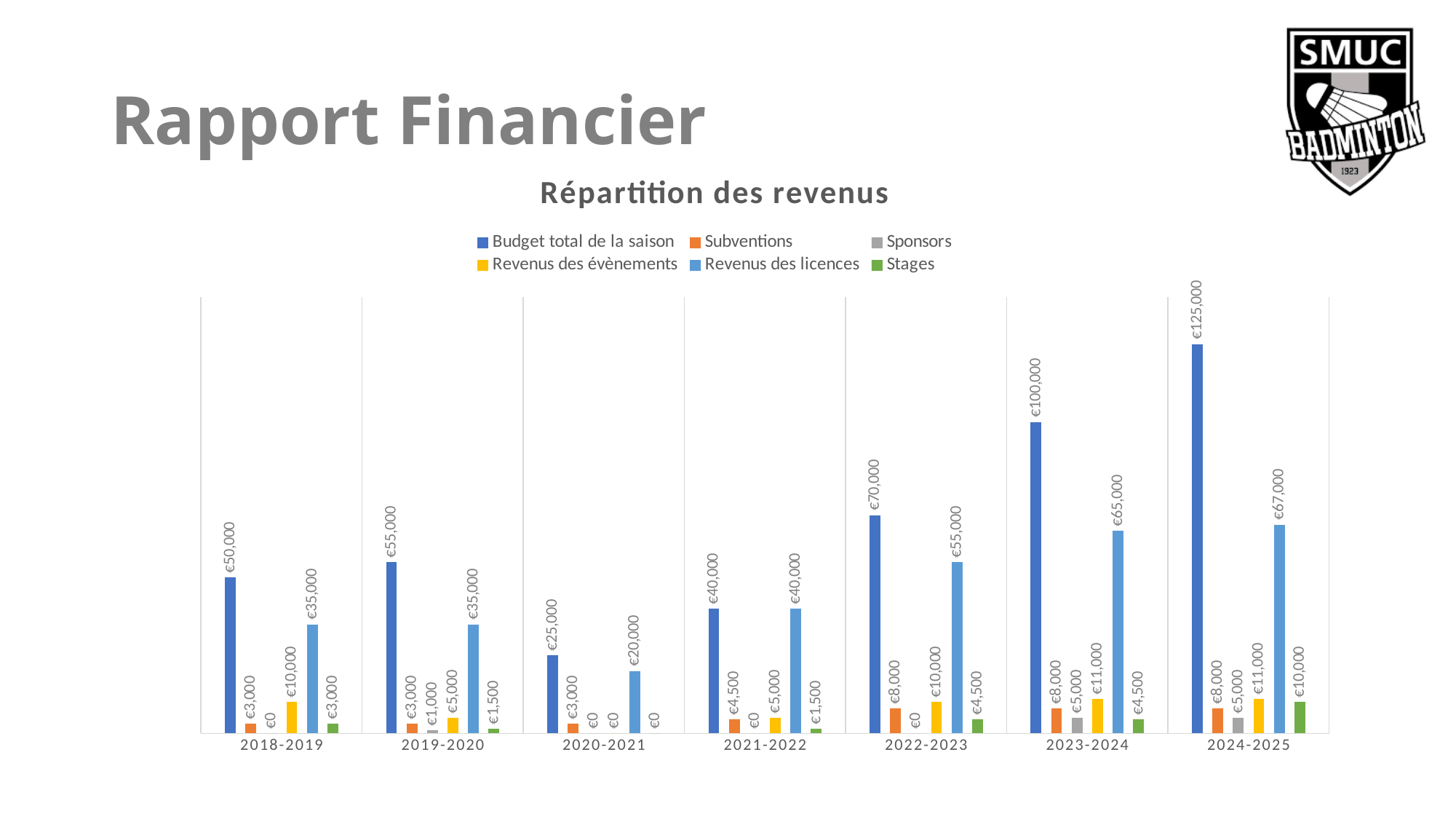
What is the value of Budget total de la saison for 2024-2025? €125,000 What is the value of Stages for 2024-2025? €10,000 What is the difference between Budget total de la saison in 2024-2025 and 2023-2024? €25,000 What kind of chart is shown? Bar chart How many seasons are shown on the x axis? 7 Which season has the highest Revenus des licences? 2024-2025 What is the title of the chart? Répartition des revenus What is the value of Revenus des licences for 2023-2024? €65,000 Which season has the lowest Budget total de la saison? 2020-2021 How many series does the legend list? 6 What is the value of Revenus des évènements for 2018-2019? €10,000 Which is larger: Revenus des licences in 2022-2023 or Revenus des licences in 2021-2022? 2022-2023